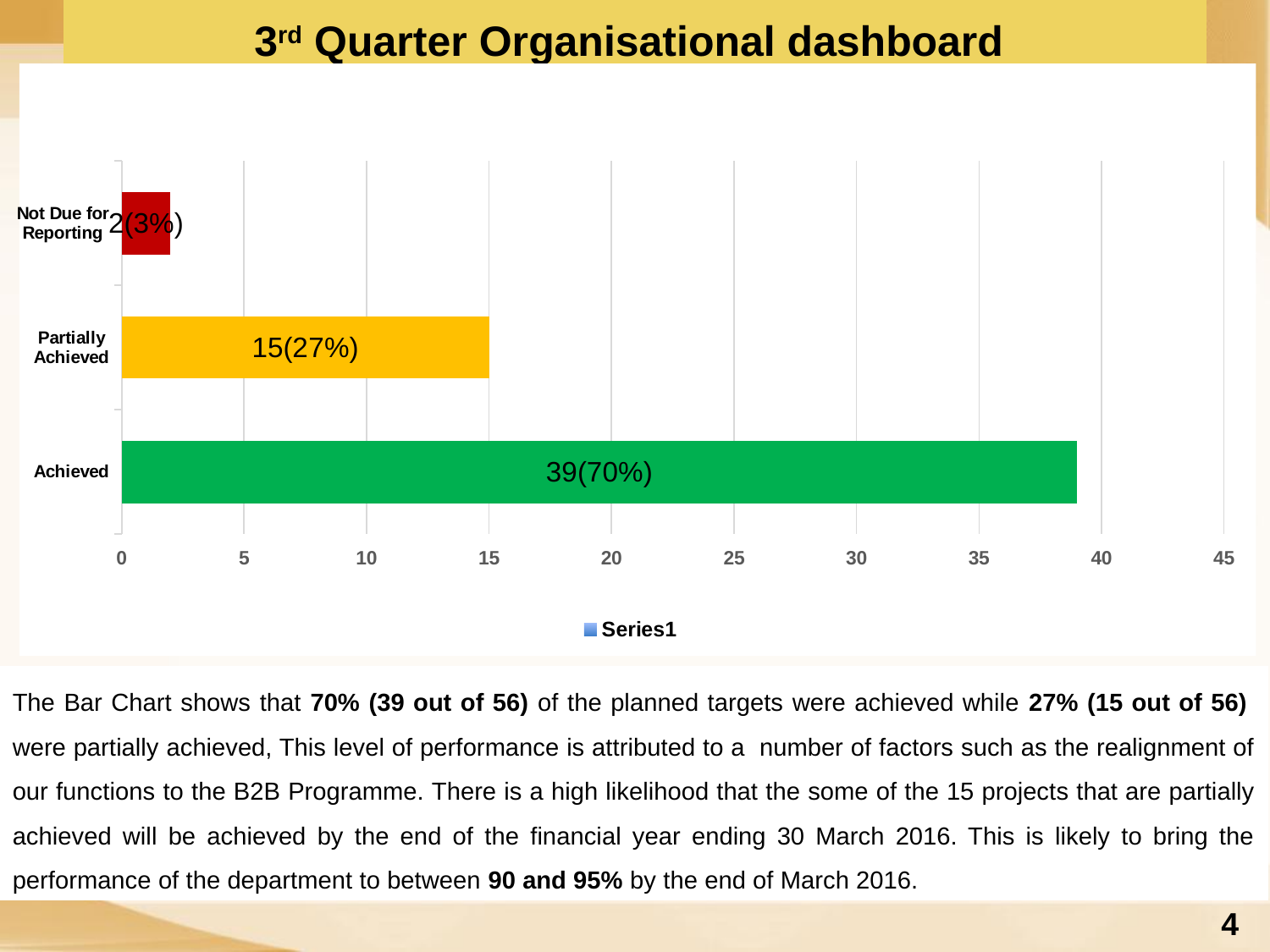
What is the data label shown on the Partially Achieved bar? 15(27%) Which category has the lowest value? Not Due for Reporting Which is larger, the value for Partially Achieved or the value for Not Due for Reporting? Partially Achieved How many categories are shown in the chart? 3 Is the value for Achieved greater or less than 35? greater What is the data label shown on the Achieved bar? 39(70%) What kind of chart is shown on the slide? Bar chart What is the difference in count between Achieved and Partially Achieved? 24 How many series does the legend list? 1 What is the total count across all three categories? 56 What is the data label shown on the Not Due for Reporting bar? 2(3%) Which category has the highest value? Achieved